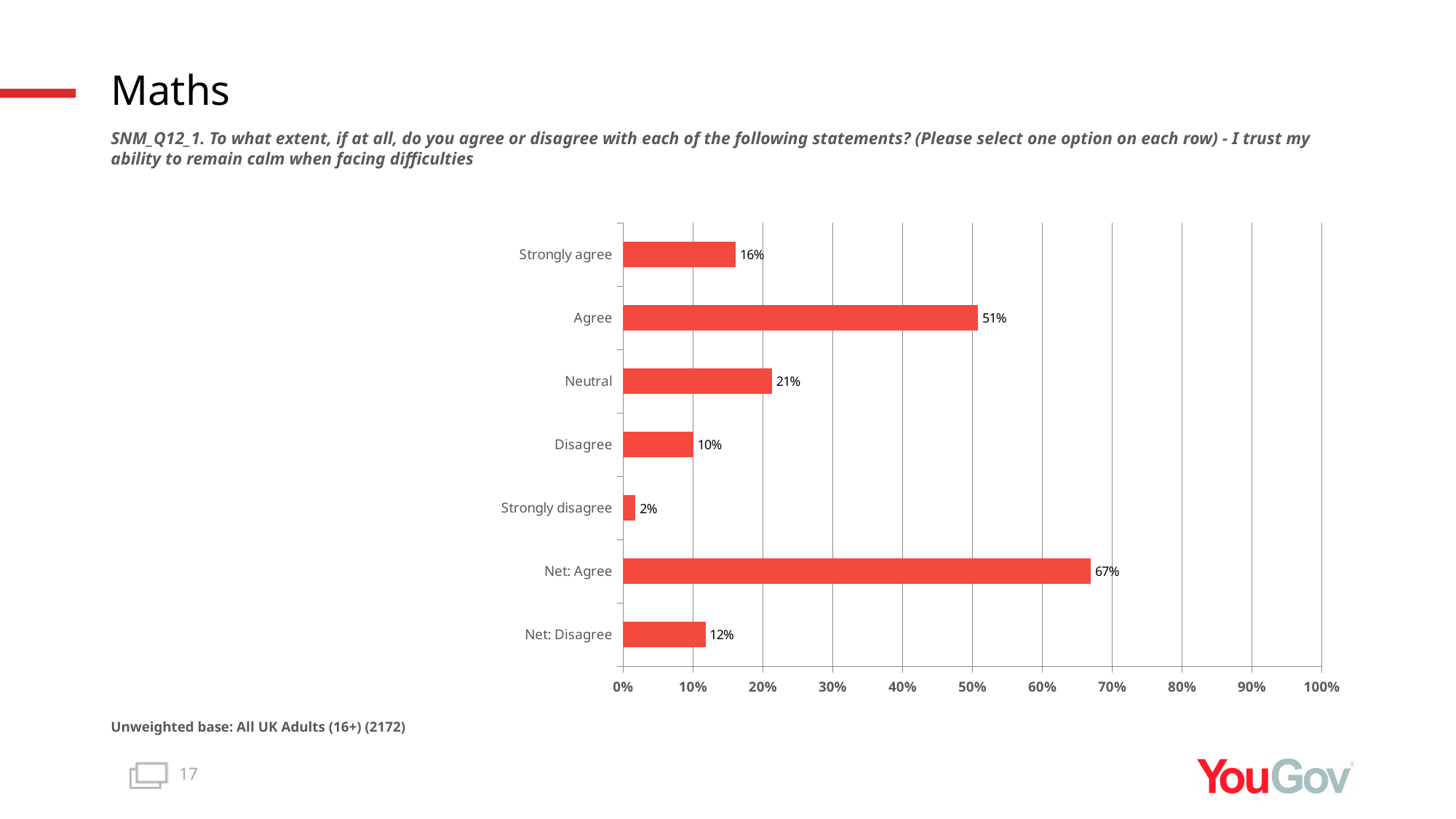
What is the value shown for 'Strongly disagree'? 2% Which is larger, the value for 'Strongly agree' or the value for 'Disagree'? Strongly agree Which category has the highest value on the chart? Net: Agree What kind of chart is shown on the slide? Bar chart Which category has the lowest value on the chart? Strongly disagree What percentage of respondents selected 'Agree'? 51% Is the value for 'Agree' greater or less than 50%? greater What is the unweighted base stated below the chart? All UK Adults (16+) (2172) How many categories are shown on the chart? 7 What is the difference between the 'Neutral' and 'Strongly agree' values? 5% What is the value shown for 'Net: Disagree'? 12% What is the difference between the 'Net: Agree' and 'Net: Disagree' values? 55%